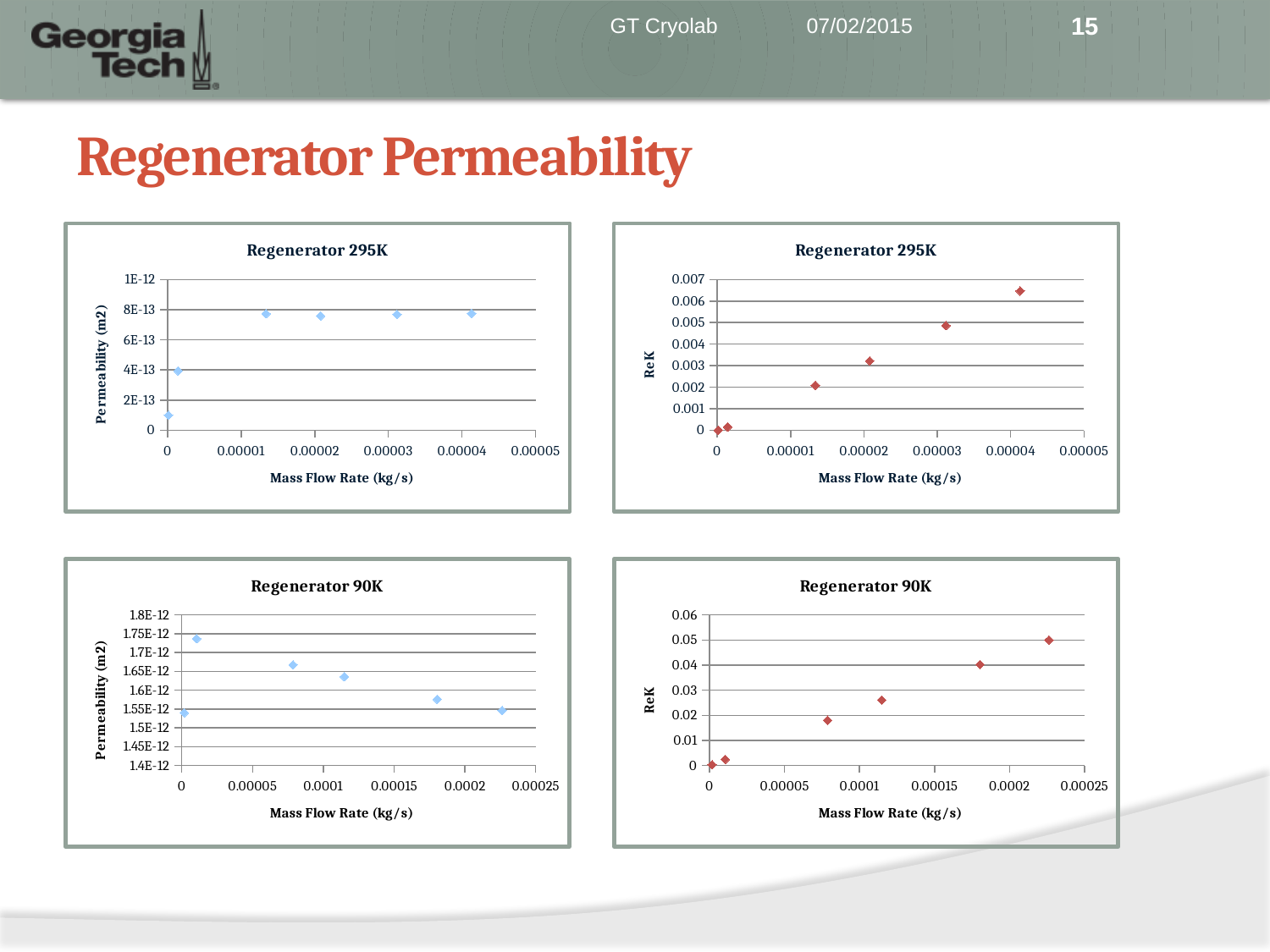
What kind of chart is the top-left 'Regenerator 295K' chart? scatter chart How many charts are shown on the slide? 4 In the bottom-right 'Regenerator 90K' ReK chart, do the values rise or fall as mass flow rate increases? rise In the top-right 'Regenerator 295K' ReK chart, is the ReK value of the point at the highest mass flow rate greater or less than 0.006? greater In the bottom-right 'Regenerator 90K' ReK chart, is the ReK value of the point at the highest mass flow rate greater or less than 0.04? greater In the bottom-left 'Regenerator 90K' permeability chart, is the permeability of the point at the highest mass flow rate greater or less than 1.65E-12? less In the top-right 'Regenerator 295K' ReK chart, do the values rise or fall as mass flow rate increases? rise What is the y-axis label of the two charts on the right side of the slide? ReK What is the x-axis label shared by all four charts? Mass Flow Rate (kg/s) How many data points are plotted in the top-right 'Regenerator 295K' ReK chart? 6 How many data points are plotted in the bottom-left 'Regenerator 90K' permeability chart? 6